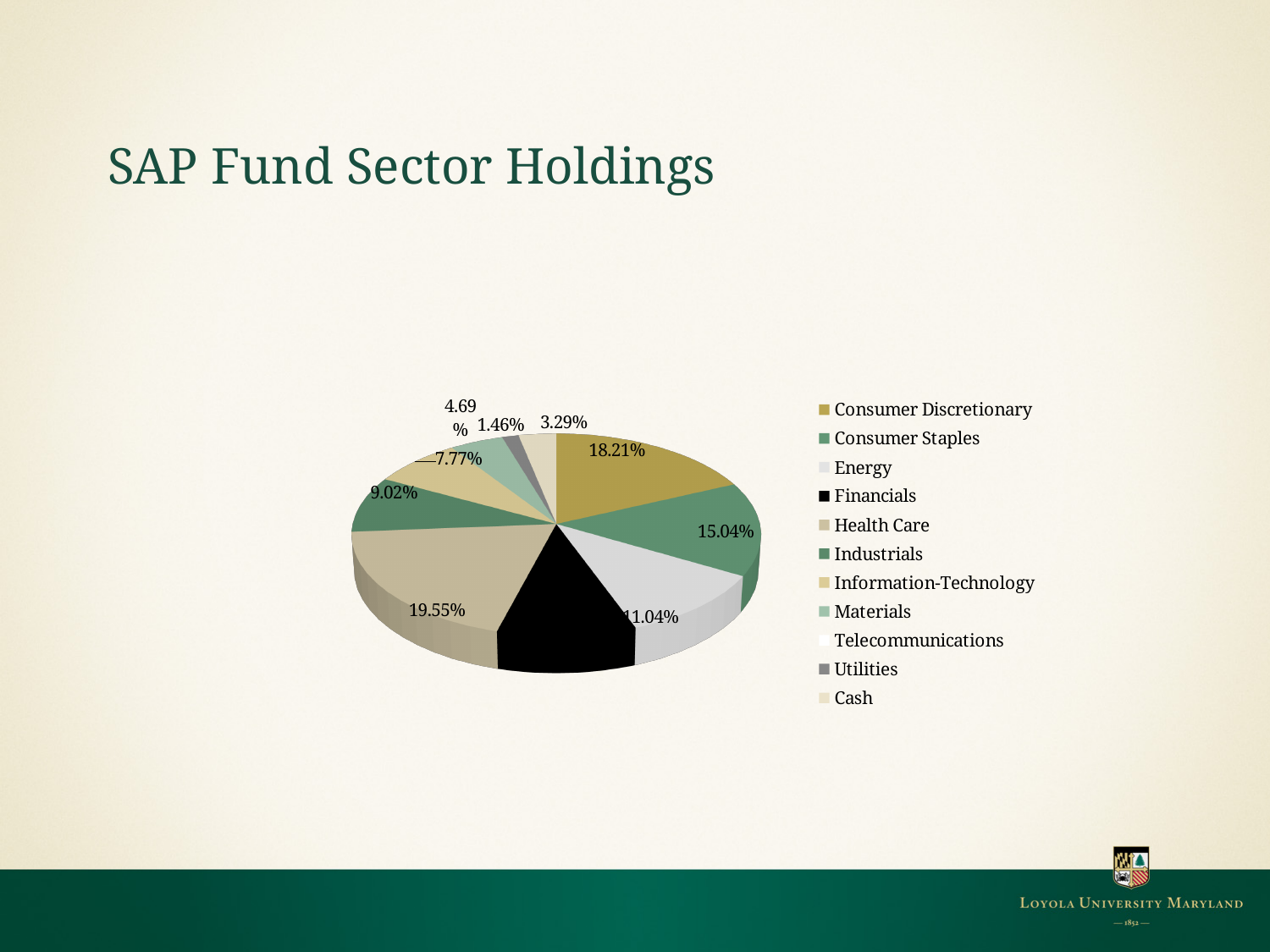
What share of the SAP Fund is held in Materials? 4.69% What share of the SAP Fund is held in Consumer Discretionary? 18.21% How much larger is the Consumer Discretionary share than the Consumer Staples share? 3.17% How many sectors does the legend of the pie chart list? 11 What share of the SAP Fund is held in Industrials? 9.02% What share of the SAP Fund is held in Utilities? 1.46% What share of the SAP Fund is held in Health Care? 19.55% What kind of chart is shown on the slide? pie chart What is the title of the slide? SAP Fund Sector Holdings What share of the SAP Fund is held in Energy? 11.04% Which sector has the largest share of the SAP Fund holdings? Health Care Which sector has the larger share, Consumer Staples or Energy? Consumer Staples